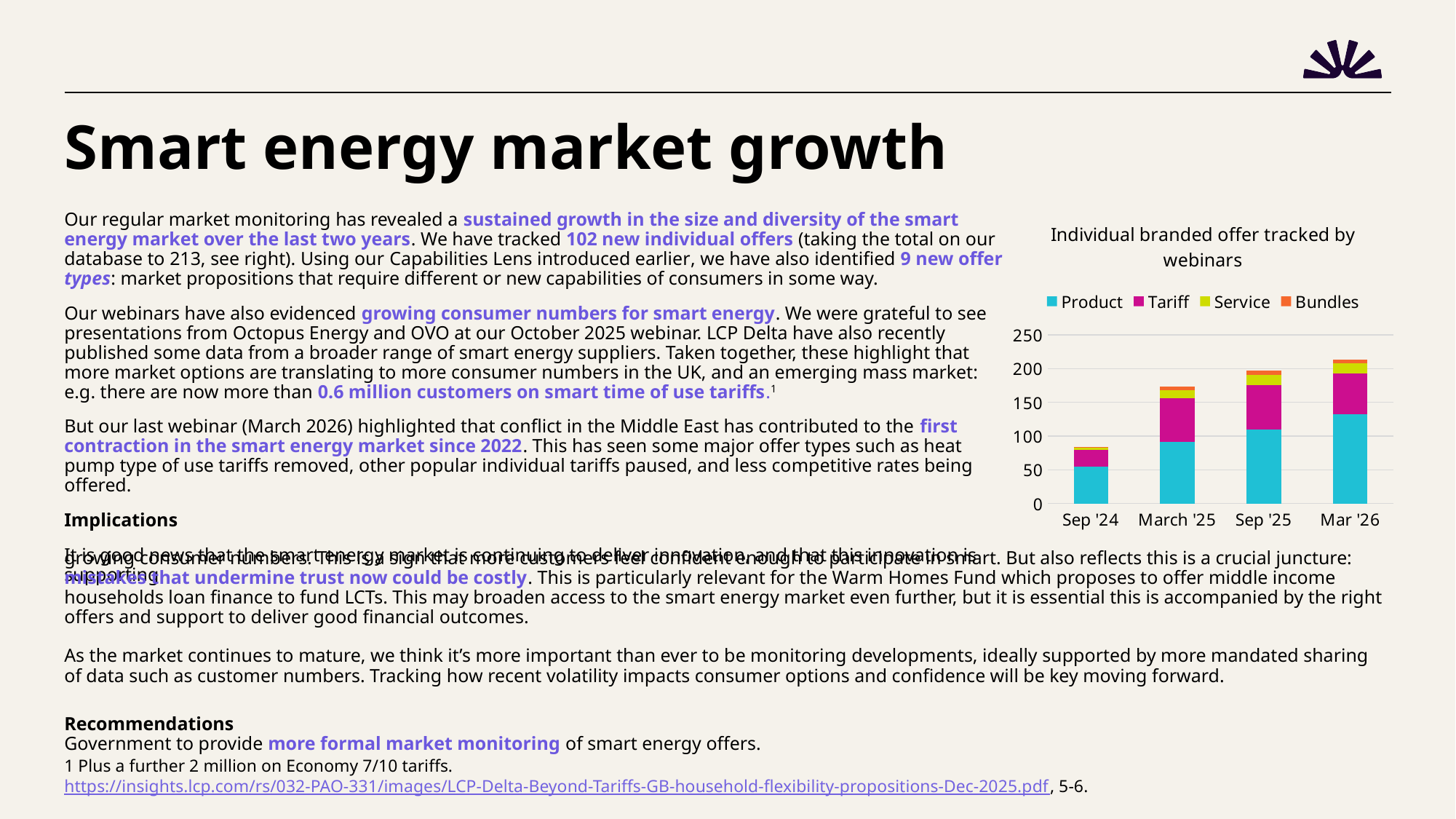
Which period has the tallest stacked bar in the chart? Mar '26 Which series is shown in pink in the chart? Tariff What is the title of the chart on the slide? Individual branded offer tracked by webinars Is the Product value for Mar '26 greater or less than 100? greater Is the total bar height for Mar '26 greater or less than 200? greater What kind of chart is shown on the slide? Stacked bar chart Which period has the shortest stacked bar in the chart? Sep '24 Is the total bar height for Sep '24 greater or less than 100? less Which is larger, the Product value for Mar '26 or the Product value for Sep '24? Mar '26 Do the total bar heights rise or fall from Sep '24 to Mar '26? rise How many time periods are shown on the x axis of the chart? 4 How many series does the chart legend list? 4